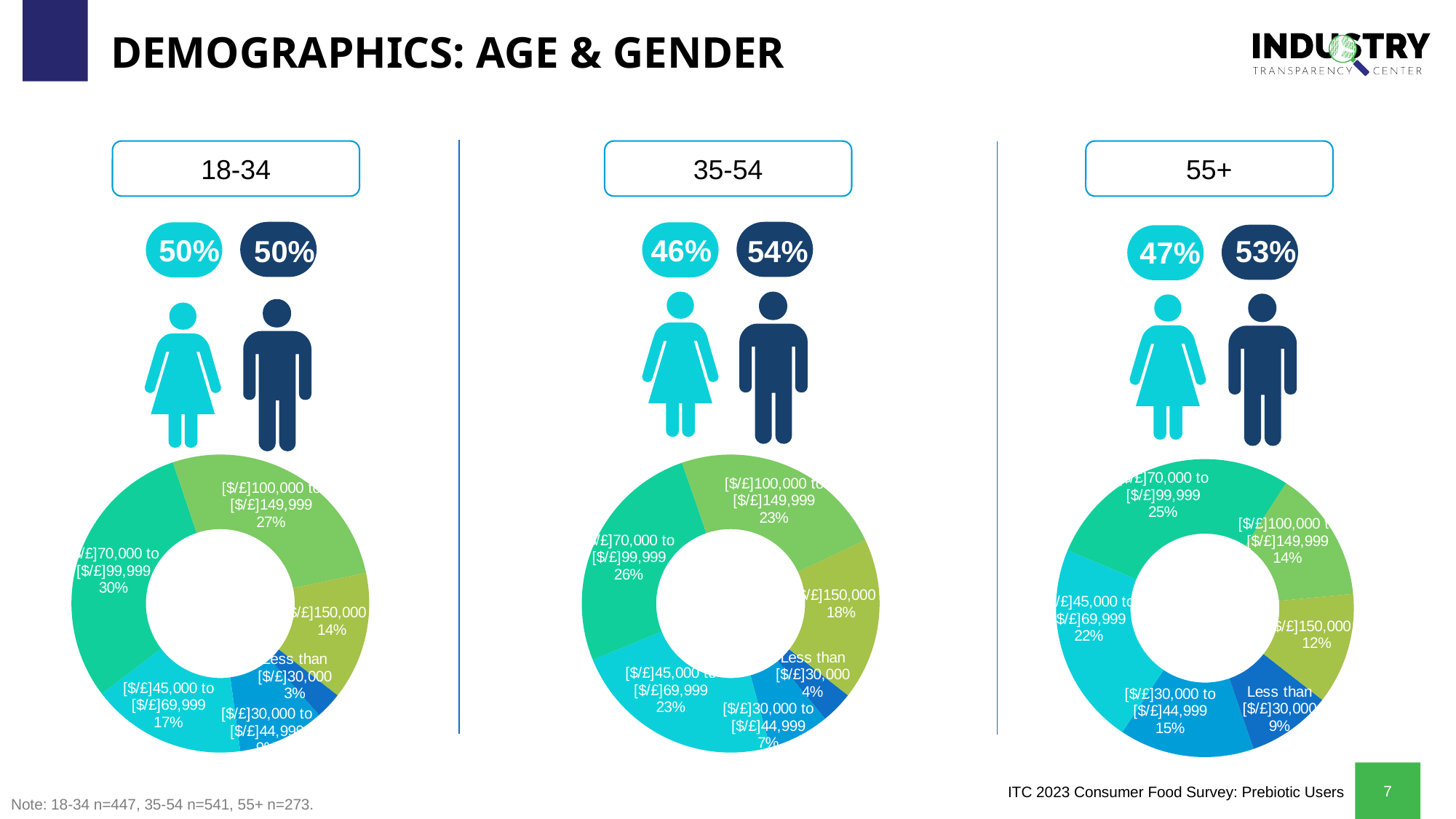
In the 35-54 age group, what percentage of respondents are male? 54% In the 18-34 donut chart, what is the difference between the share for [$/£]100,000 to [$/£]149,999 and the share for less than [$/£]30,000? 24% In the 55+ donut chart, which income bracket has the largest share? [$/£]70,000 to [$/£]99,999 In the 35-54 donut chart, which is larger: the share for [$/£]70,000 to [$/£]99,999 or the share for [$/£]100,000 to [$/£]149,999? [$/£]70,000 to [$/£]99,999 In the 55+ donut chart, what share of respondents earn [$/£]30,000 to [$/£]44,999? 15% In the 18-34 donut chart, what share of respondents earn [$/£]70,000 to [$/£]99,999? 30% How many income brackets are shown in the 35-54 donut chart? 6 In the 35-54 donut chart, which income bracket has the smallest share? Less than [$/£]30,000 What type of chart is used to show income distribution for each age group? Donut (pie) chart In the 35-54 donut chart, what share of respondents earn [$/£]45,000 to [$/£]69,999? 23% In the 18-34 donut chart, which income bracket has the largest share? [$/£]70,000 to [$/£]99,999 In the 55+ donut chart, what share of respondents earn less than [$/£]30,000? 9%